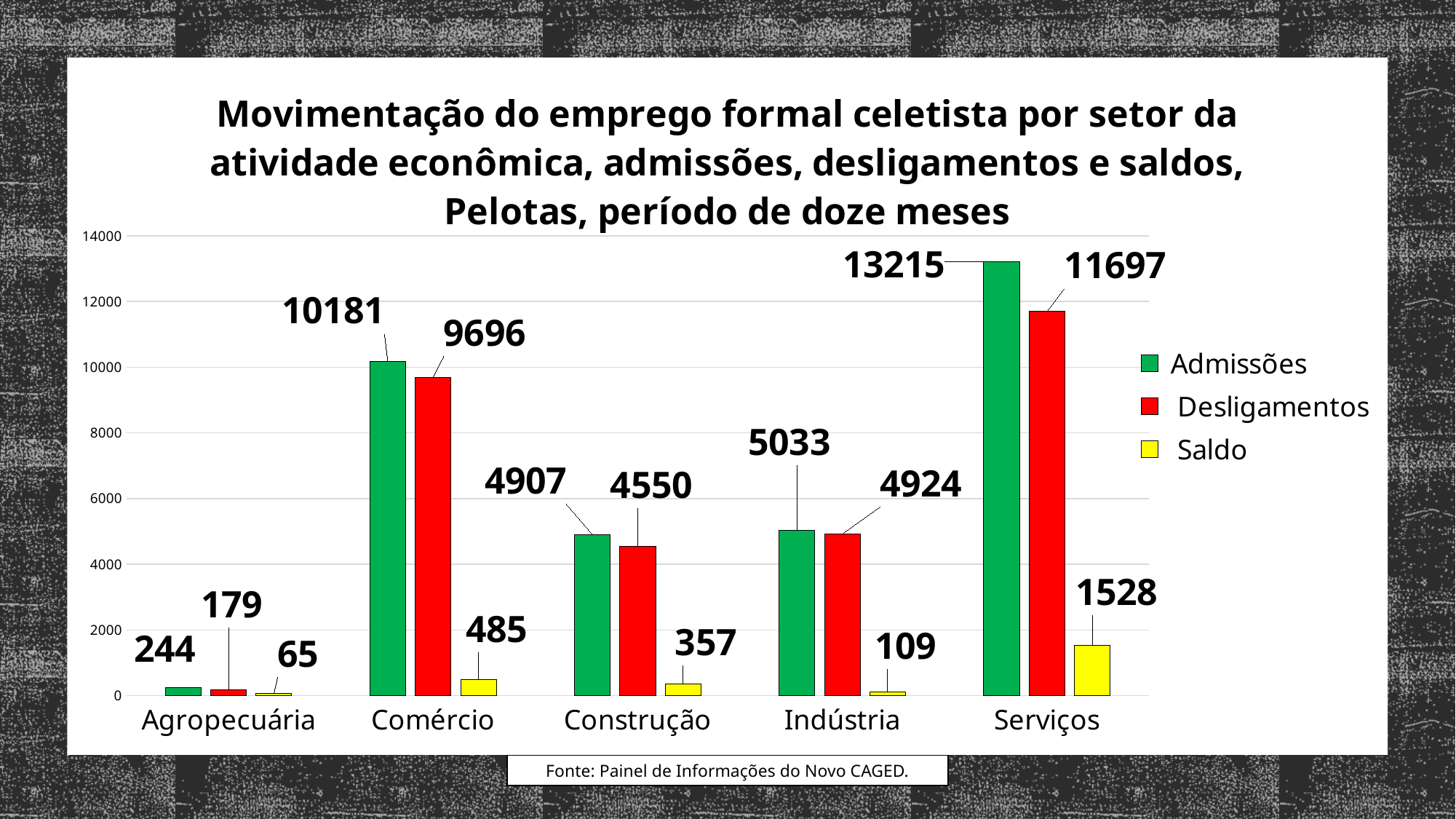
Is the Desligamentos value for Serviços greater or less than 10000? greater Which is larger: the Saldo for Comércio or the Saldo for Construção? Comércio Which colour represents Saldo in the legend? Yellow What is the value of Desligamentos for Comércio? 9696 What is the value of Admissões for Serviços? 13215 What is the difference between Admissões and Desligamentos for Construção? 357 What is the Saldo value for Indústria? 109 How many series does the legend list? 3 What kind of chart is shown on the slide? Bar chart How many sectors are shown on the x axis? 5 Which sector has the lowest Saldo value? Agropecuária Which sector has the highest Admissões value? Serviços